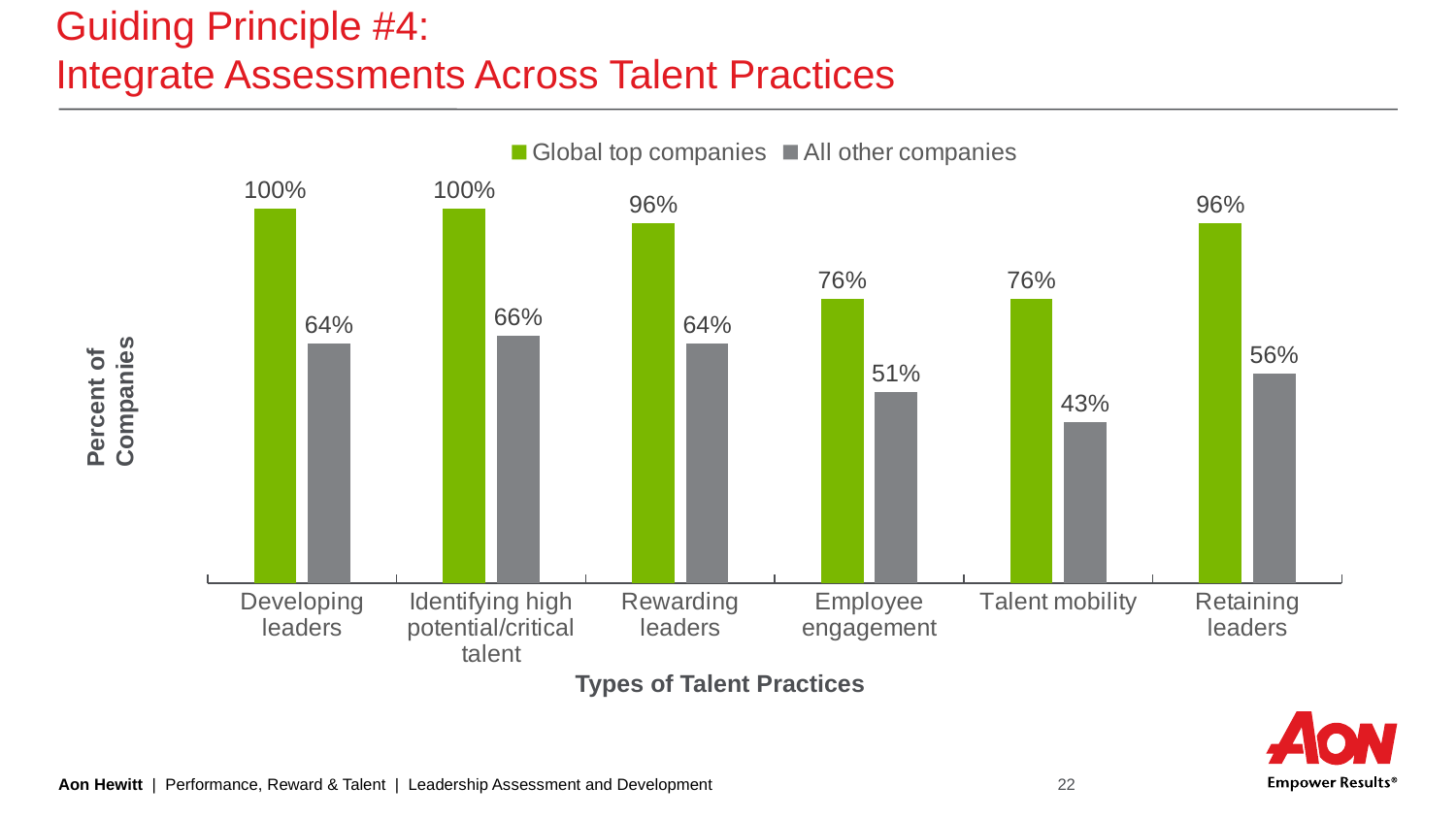
What is the value for Global top companies in the Developing leaders category? 100% How many categories are shown on the x axis? 6 What is the value for All other companies in the Employee engagement category? 51% Which is larger: the All other companies value for Rewarding leaders or for Retaining leaders? Rewarding leaders Which category has the lowest value for All other companies? Talent mobility What is the difference between Global top companies and All other companies in the Developing leaders category? 36% How many series does the legend list? 2 Which category has the highest value for All other companies? Identifying high potential/critical talent What is the value for All other companies in the Talent mobility category? 43% What is the difference between Global top companies and All other companies in the Talent mobility category? 33% What kind of chart is shown on the slide? Bar chart What is the value for Global top companies in the Retaining leaders category? 96%